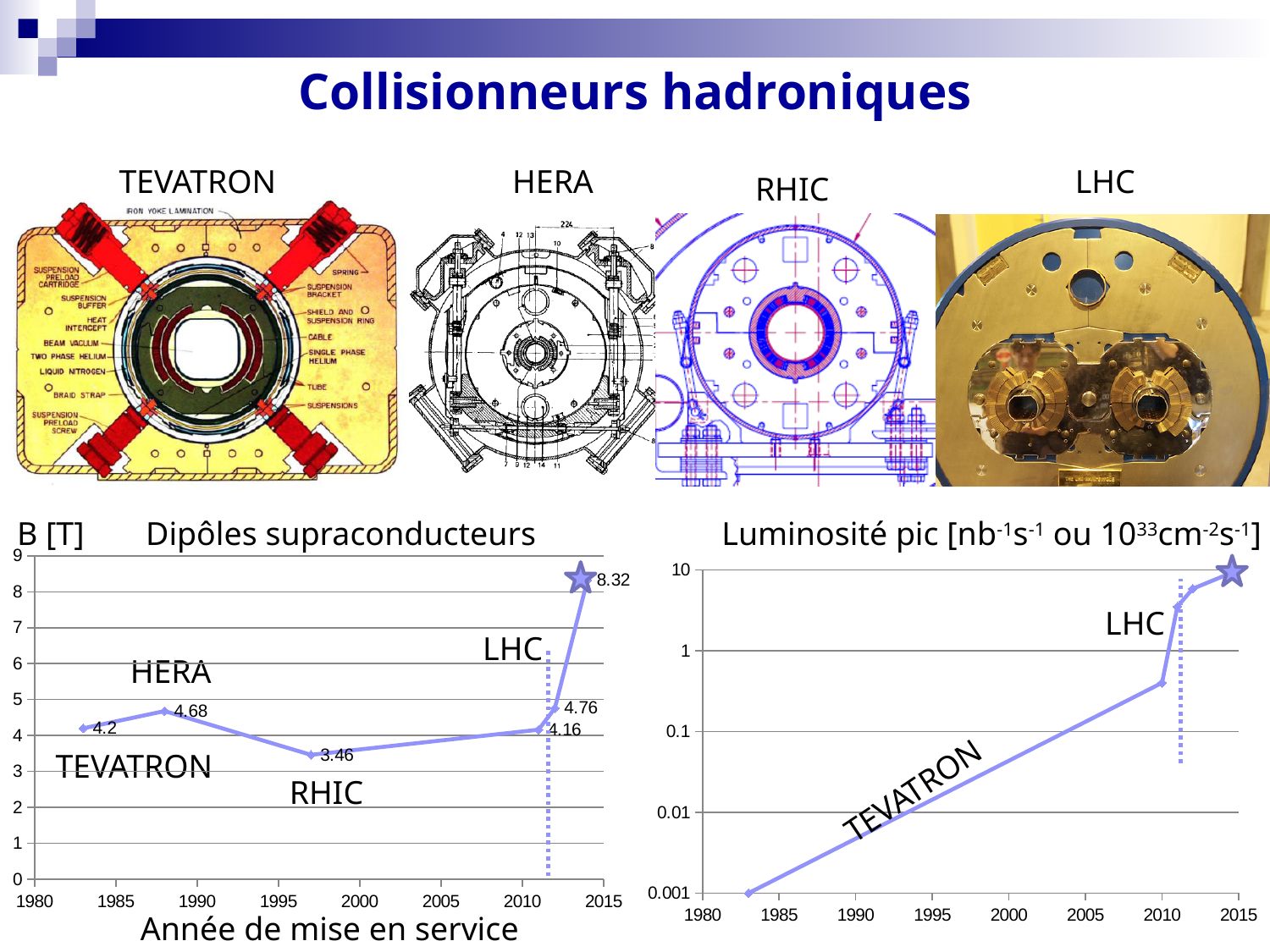
What is the x-axis title of the 'Dipôles supraconducteurs' chart? Année de mise en service In the 'Luminosité pic' chart, is the value at 2010 greater or less than 0.1? greater In the 'Luminosité pic' chart, do the values rise or fall from 1980 to 2015? rise In the 'Dipôles supraconducteurs' chart, what is the B [T] value labelled for RHIC? 3.46 In the 'Dipôles supraconducteurs' chart, what is the highest labelled value? 8.32 In the 'Dipôles supraconducteurs' chart, what is the B [T] value labelled for TEVATRON? 4.2 In the 'Dipôles supraconducteurs' chart, which is larger, the HERA value or the RHIC value? HERA In the 'Dipôles supraconducteurs' chart, how many data points have a printed value label? 6 In the 'Dipôles supraconducteurs' chart, which collider has the lowest labelled dipole field? RHIC In the 'Dipôles supraconducteurs' chart, what is the difference between the HERA value and the TEVATRON value? 0.48 In the 'Dipôles supraconducteurs' chart, what is the B [T] value labelled for HERA? 4.68 What kind of chart is the 'Luminosité pic' chart on the right? line chart